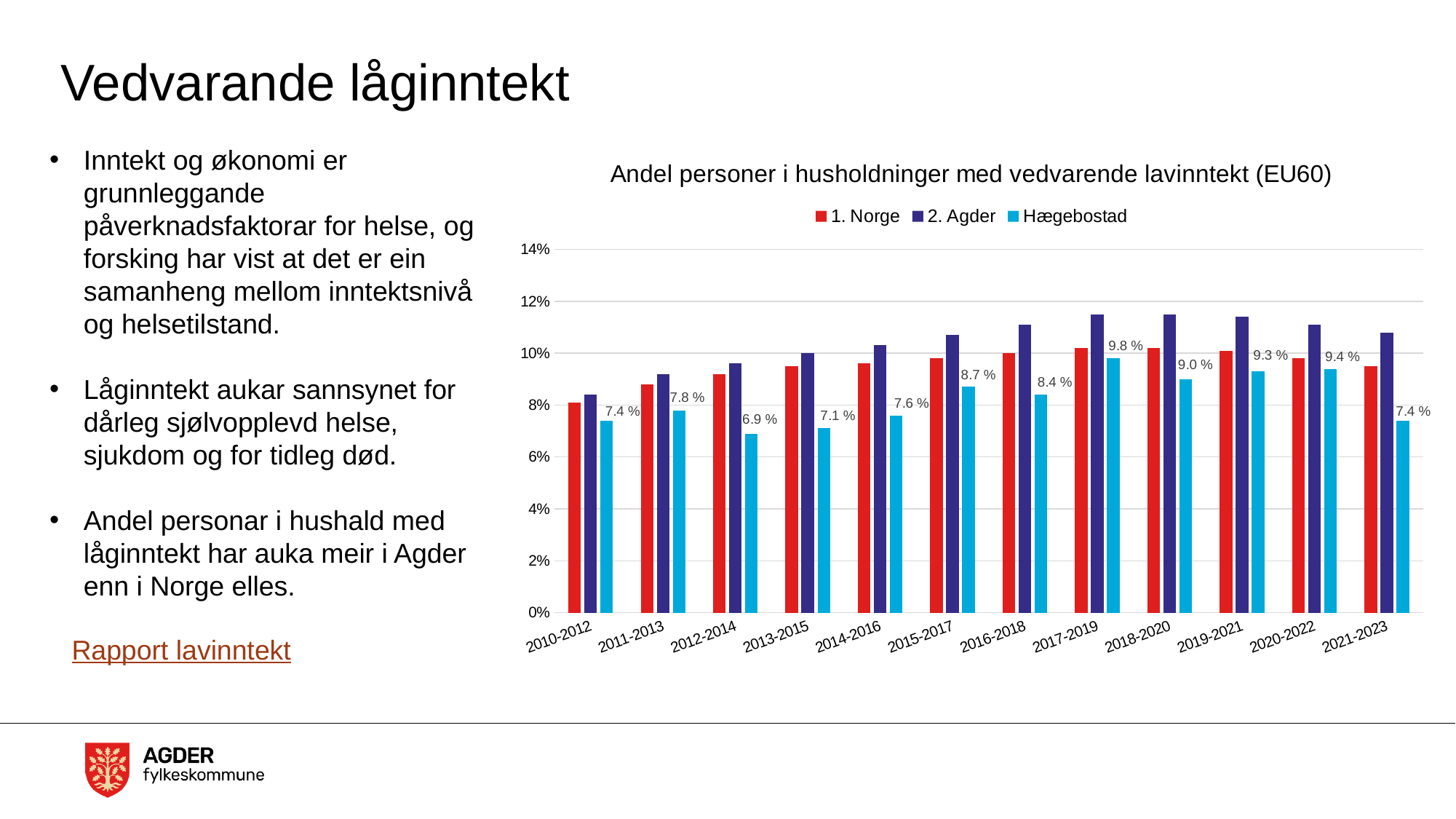
Is the value for 1. Norge in 2010-2012 greater or less than 10%? less In which period is the Hægebostad value highest? 2017-2019 How many series does the legend list? 3 Which series has the larger value in 2021-2023, 1. Norge or 2. Agder? 2. Agder What is the difference between the Hægebostad values for 2017-2019 and 2012-2014? 2.9 % Is the value for 2. Agder in 2017-2019 greater or less than 10%? greater Which period has the larger Hægebostad value, 2015-2017 or 2016-2018? 2015-2017 In which period is the Hægebostad value lowest? 2012-2014 What is the value for Hægebostad in 2012-2014? 6.9 % How many periods are shown on the x axis? 12 What kind of chart is shown on the slide? bar chart What is the value for Hægebostad in 2017-2019? 9.8 %